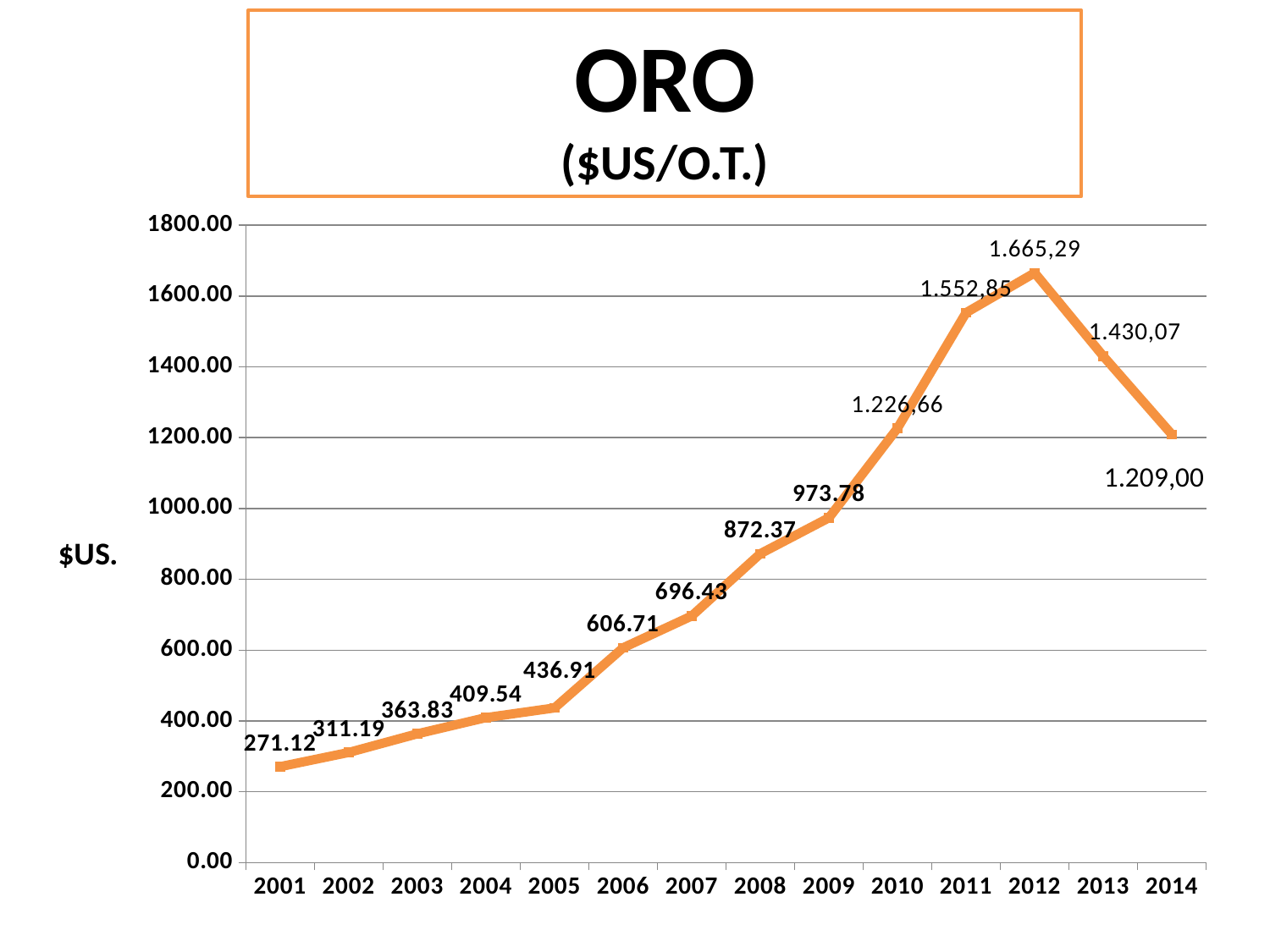
Which year has the lowest value? 2001 What type of chart is shown on the slide? line chart How many years are plotted on the x axis? 14 Do the values rise or fall from 2001 to 2012? rise What is the value for 2001? 271.12 What is the title of the chart? ORO ($US/O.T.) Which year has the highest value? 2012 Which is larger, the value for 2013 or the value for 2014? 2013 What is the value for 2014? 1.209,00 What is the value for 2012? 1.665,29 What is the value for 2008? 872.37 What is the difference between the values for 2009 and 2008? 101.41